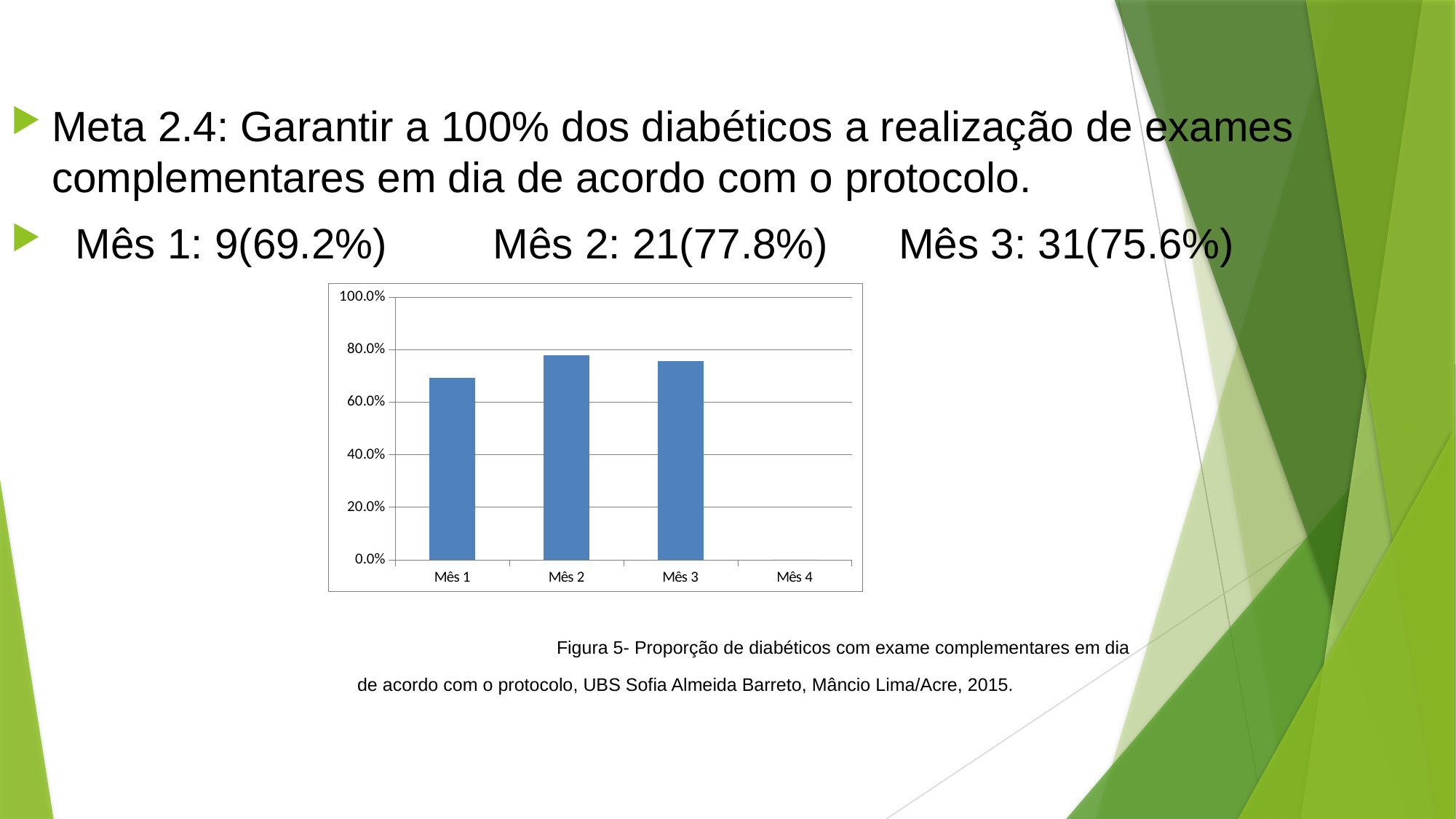
What is the difference between the values for Mês 3 and Mês 1? 6.4% Which is larger, the value for Mês 1 or the value for Mês 3? Mês 3 How many categories are shown on the x axis? 4 What type of chart is shown on the slide? bar chart Which month has the highest bar? Mês 2 What is the difference between the values for Mês 2 and Mês 1? 8.6% Is the value for Mês 1 greater or less than 80.0%? less Does the value rise or fall from Mês 2 to Mês 3? fall Which of the three months with bars has the lowest value? Mês 1 What is the value for Mês 1? 69.2% What is the value for Mês 3? 75.6% What is the value for Mês 2? 77.8%